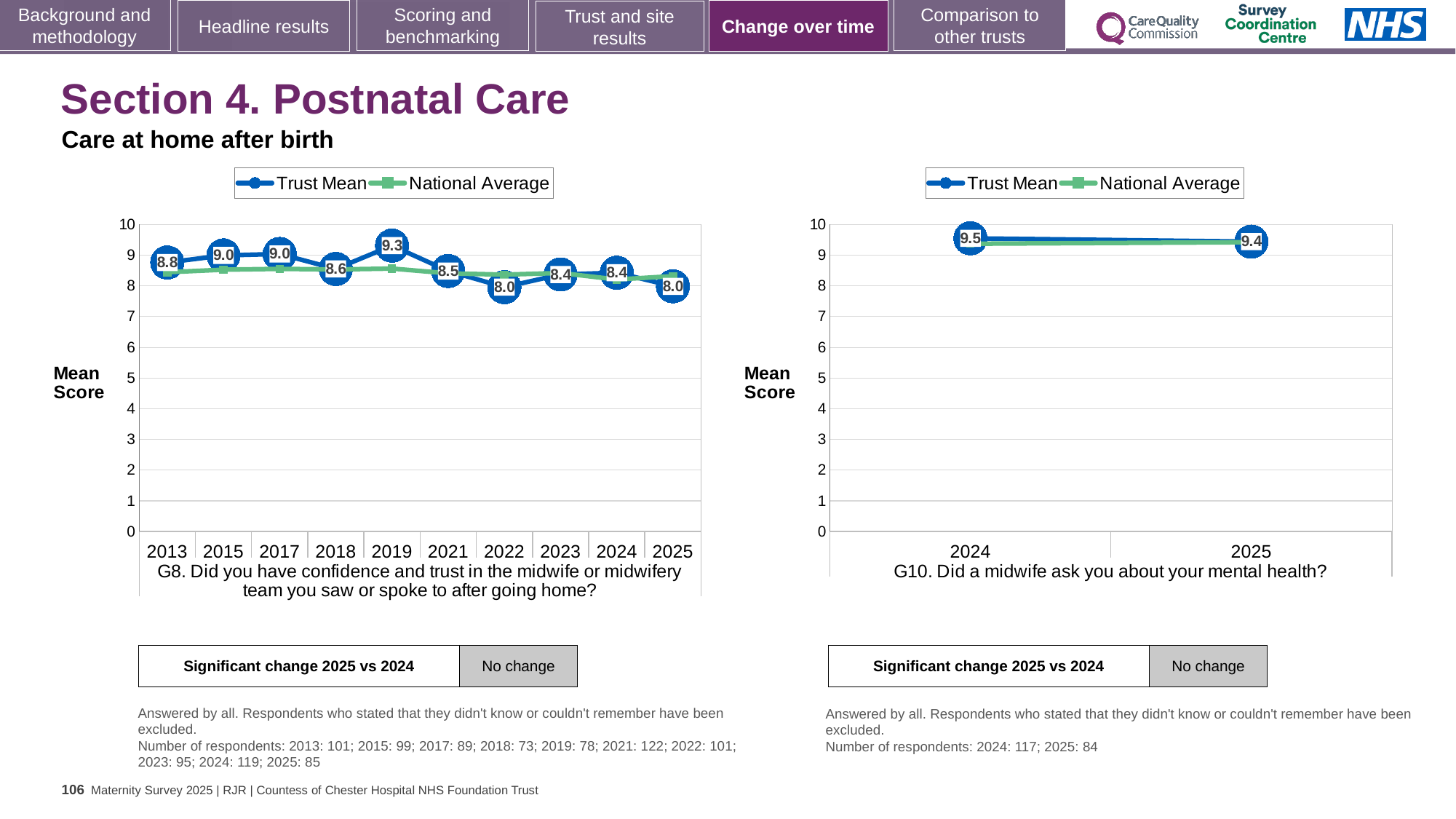
In the G10 chart on the right, what is the Trust Mean for 2024? 9.5 In the G10 chart on the right, what is the difference between the Trust Mean in 2024 and in 2025? 0.1 What type of chart is the G10 chart on the right? Line chart In the G10 chart on the right, how many series does the legend list? 2 In the G8 chart on the left, what is the label on the y axis? Mean Score In the G8 chart on the left, how many years are shown on the x axis? 10 In the G8 chart on the left, is the National Average for 2025 greater or less than 7? greater In the G8 chart on the left, what is the Trust Mean for 2019? 9.3 In the G8 chart on the left, what is the difference between the Trust Mean in 2019 and in 2022? 1.3 In the G8 chart on the left, is the Trust Mean higher in 2013 or in 2022? 2013 In the G8 chart on the left, which year has the highest Trust Mean? 2019 In the G8 chart on the left, what is the Trust Mean for 2025? 8.0